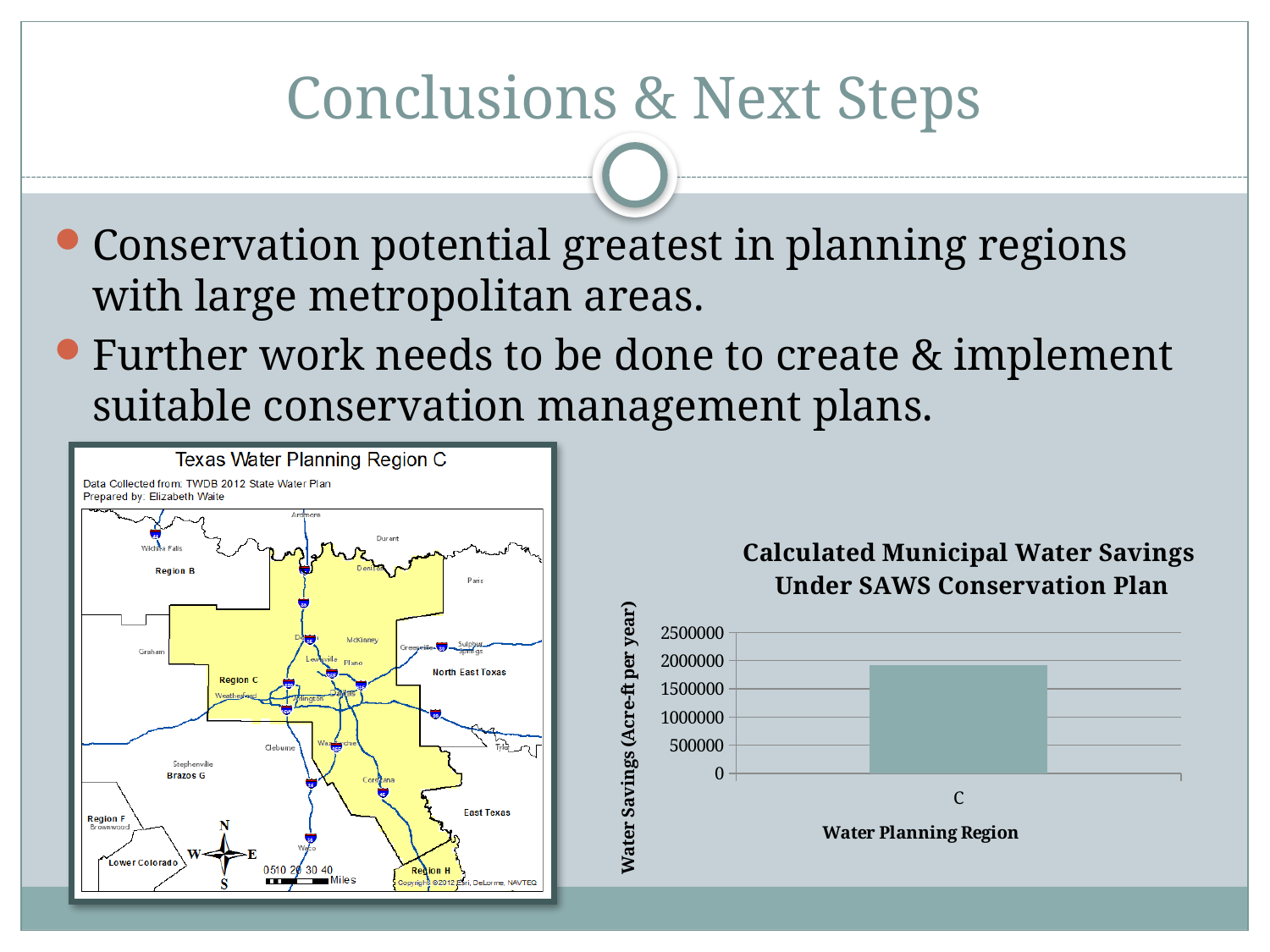
Is the value for region C greater or less than 2500000? less Is the value for region C greater or less than 1000000? greater What is the highest tick value shown on the chart's vertical axis? 2500000 What kind of chart is shown on the slide? bar chart What is the label of the chart's vertical axis? Water Savings (Acre-ft per year) What is the title of the chart? Calculated Municipal Water Savings Under SAWS Conservation Plan Which water planning region is plotted in the chart? C Is the value for region C greater or less than 2000000? less How many categories are plotted on the x axis of the chart? 1